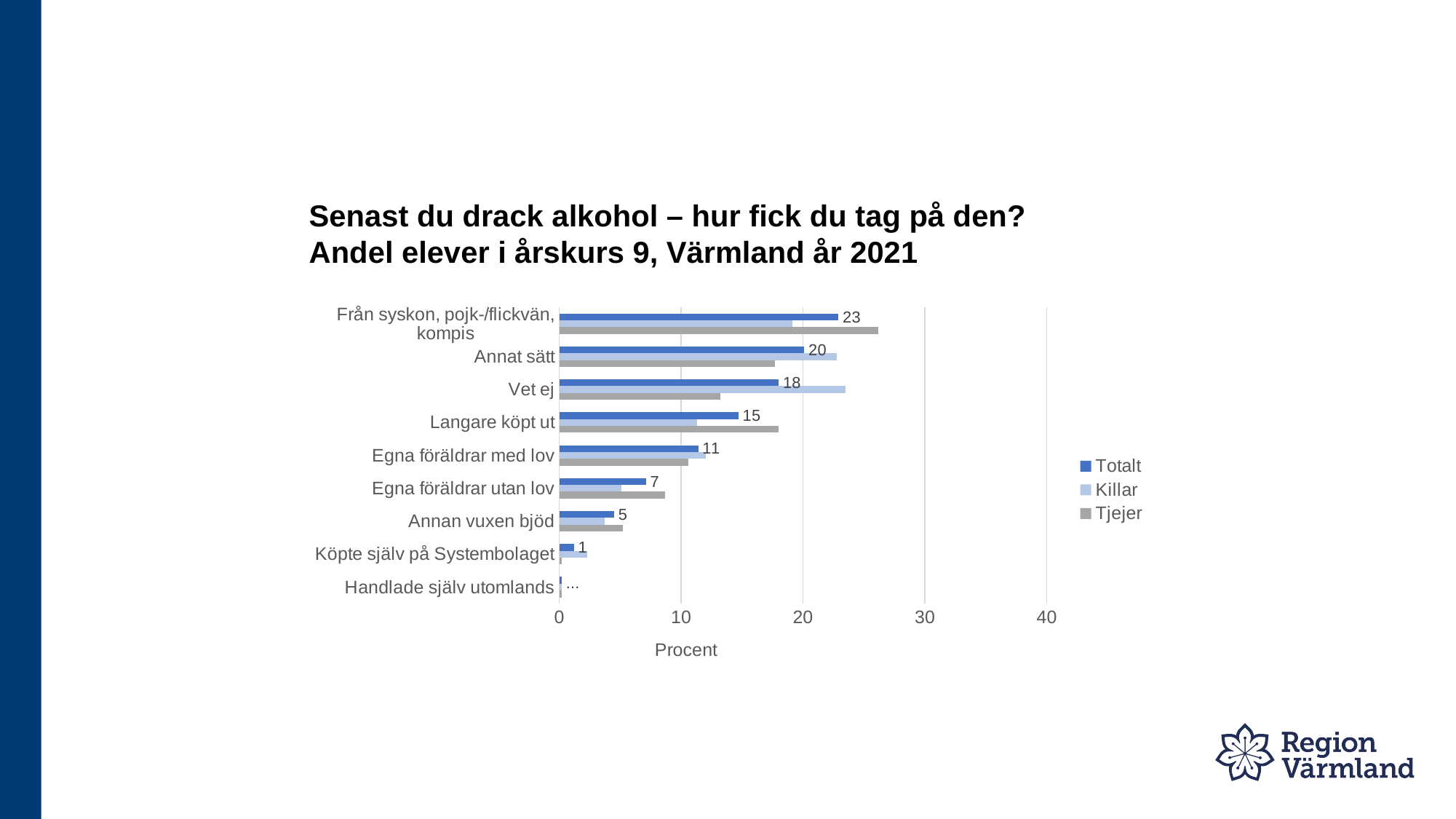
Which category has the lowest Totalt value? Handlade själv utomlands Which category has the highest Totalt value? Från syskon, pojk-/flickvän, kompis What is the Totalt value for "Köpte själv på Systembolaget"? 1 Is the Tjejer value for "Från syskon, pojk-/flickvän, kompis" greater or less than 20? greater What is the Totalt value for "Egna föräldrar utan lov"? 7 How many categories are shown on the chart? 9 Is the Killar value for "Köpte själv på Systembolaget" greater or less than 10? less What is the Totalt value for "Från syskon, pojk-/flickvän, kompis"? 23 How many series does the legend list? 3 What is the Totalt value for "Vet ej"? 18 Which has a larger Totalt value, "Langare köpt ut" or "Egna föräldrar med lov"? Langare köpt ut What is the difference between the Totalt values for "Annat sätt" and "Vet ej"? 2